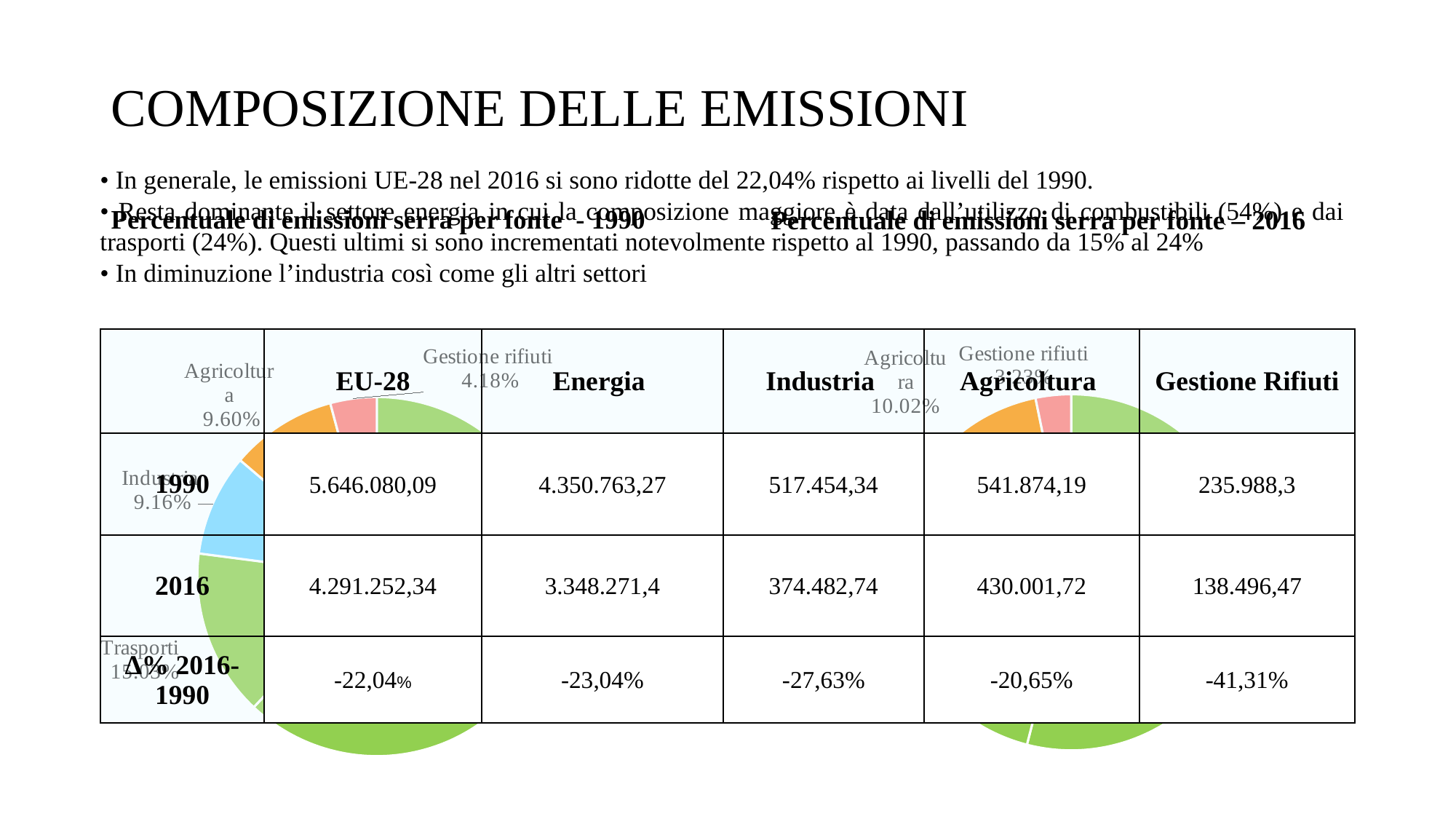
What is the title of the pie chart on the left of the slide? Percentuale di emissioni serra per fonte - 1990 In the 'Percentuale di emissioni serra per fonte - 1990' chart, which is larger, the Agricoltura slice or the Gestione rifiuti slice? Agricoltura What is the difference between the Agricoltura share in the 2016 pie chart and in the 1990 pie chart? 0.42% In the 'Percentuale di emissioni serra per fonte - 1990' chart, what share is shown for Gestione rifiuti? 4.18% Is the Agricoltura share larger in the 1990 pie chart or in the 2016 pie chart? 2016 In the 'Percentuale di emissioni serra per fonte - 1990' chart, what share is shown for Agricoltura? 9.60% What kind of chart is the 'Percentuale di emissioni serra per fonte - 1990' chart? pie chart In the 'Percentuale di emissioni serra per fonte - 1990' chart, what share is shown for Industria? 9.16% In the 'Percentuale di emissioni serra per fonte - 1990' chart, what is the difference between the Agricoltura share and the Gestione rifiuti share? 5.42% What is the title of the pie chart on the right of the slide? Percentuale di emissioni serra per fonte – 2016 What kind of chart is the 'Percentuale di emissioni serra per fonte – 2016' chart? pie chart In the 'Percentuale di emissioni serra per fonte – 2016' chart, what share is shown for Agricoltura? 10.02%